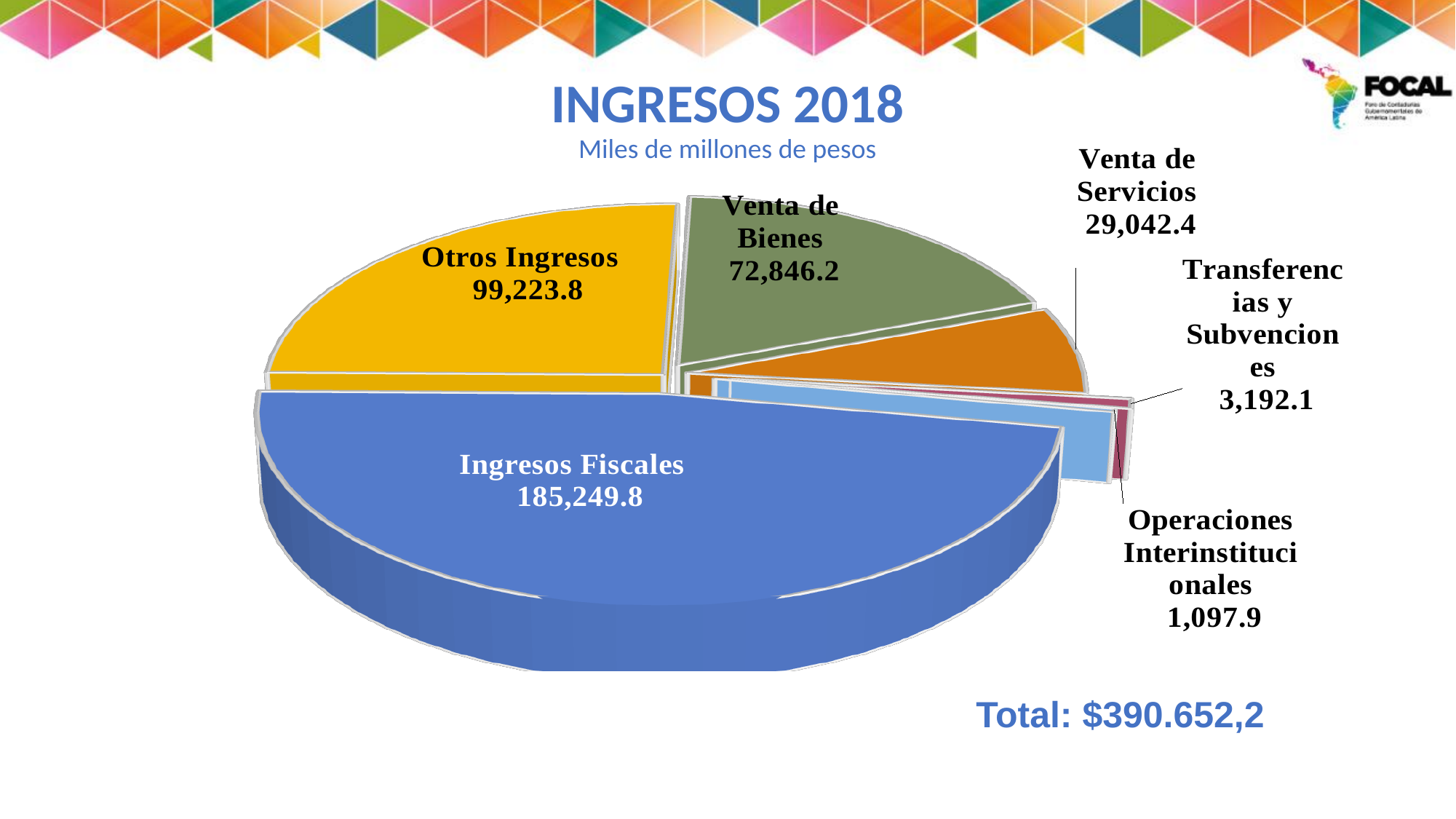
What total is printed on the slide for the pie chart? $390.652,2 What is the difference between Ingresos Fiscales and Otros Ingresos? 86,026.0 What kind of chart is shown on the slide? Pie chart What is the difference between Venta de Bienes and Venta de Servicios? 43,803.8 What unit is stated in the subtitle of the chart? Miles de millones de pesos What is the value for Venta de Servicios? 29,042.4 What is the value for Transferencias y Subvenciones? 3,192.1 What is the value for Ingresos Fiscales? 185,249.8 Which category has the largest slice of the pie? Ingresos Fiscales Which category has the smallest slice of the pie? Operaciones Interinstitucionales How many categories are shown in the pie chart? 6 Which is larger, Otros Ingresos or Venta de Bienes? Otros Ingresos